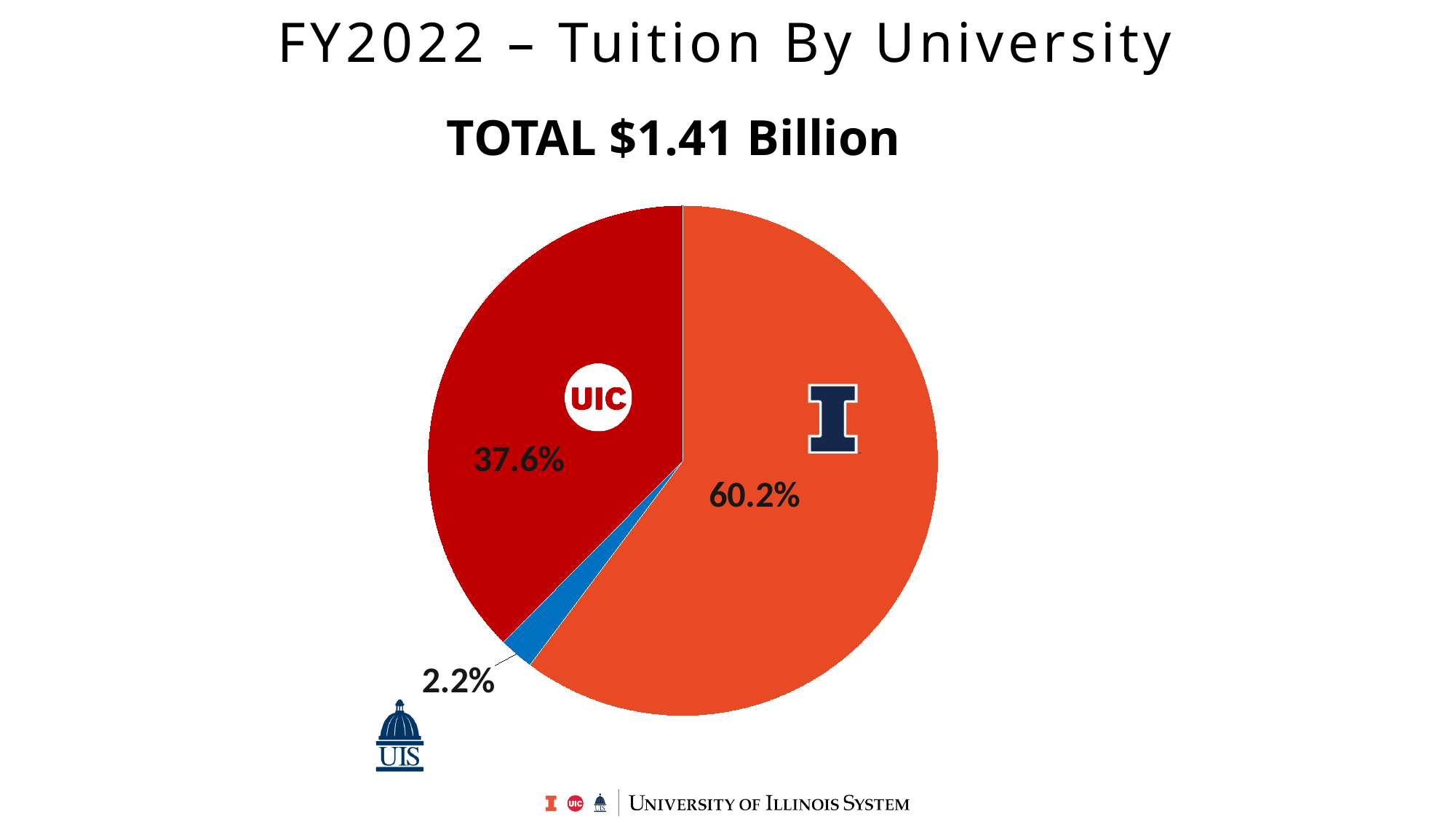
How many slices does the pie chart have? 3 What is the difference in percentage points between the UIC share and the UIS share? 35.4 What share of tuition does the UIS slice represent? 2.2% What total amount is stated above the pie chart? $1.41 Billion What is the title of the slide? FY2022 – Tuition By University Which slice of the pie is the largest? the orange slice with the Block I logo (60.2%) What type of chart is shown on the slide? pie chart What is the difference in percentage points between the Block I slice and the UIC slice? 22.6 Which university has the smallest share of tuition in the pie chart? UIS What share of tuition does the orange slice with the Block I logo represent? 60.2% Which is larger, the UIC share or the UIS share? UIC What share of tuition does the UIC slice represent? 37.6%